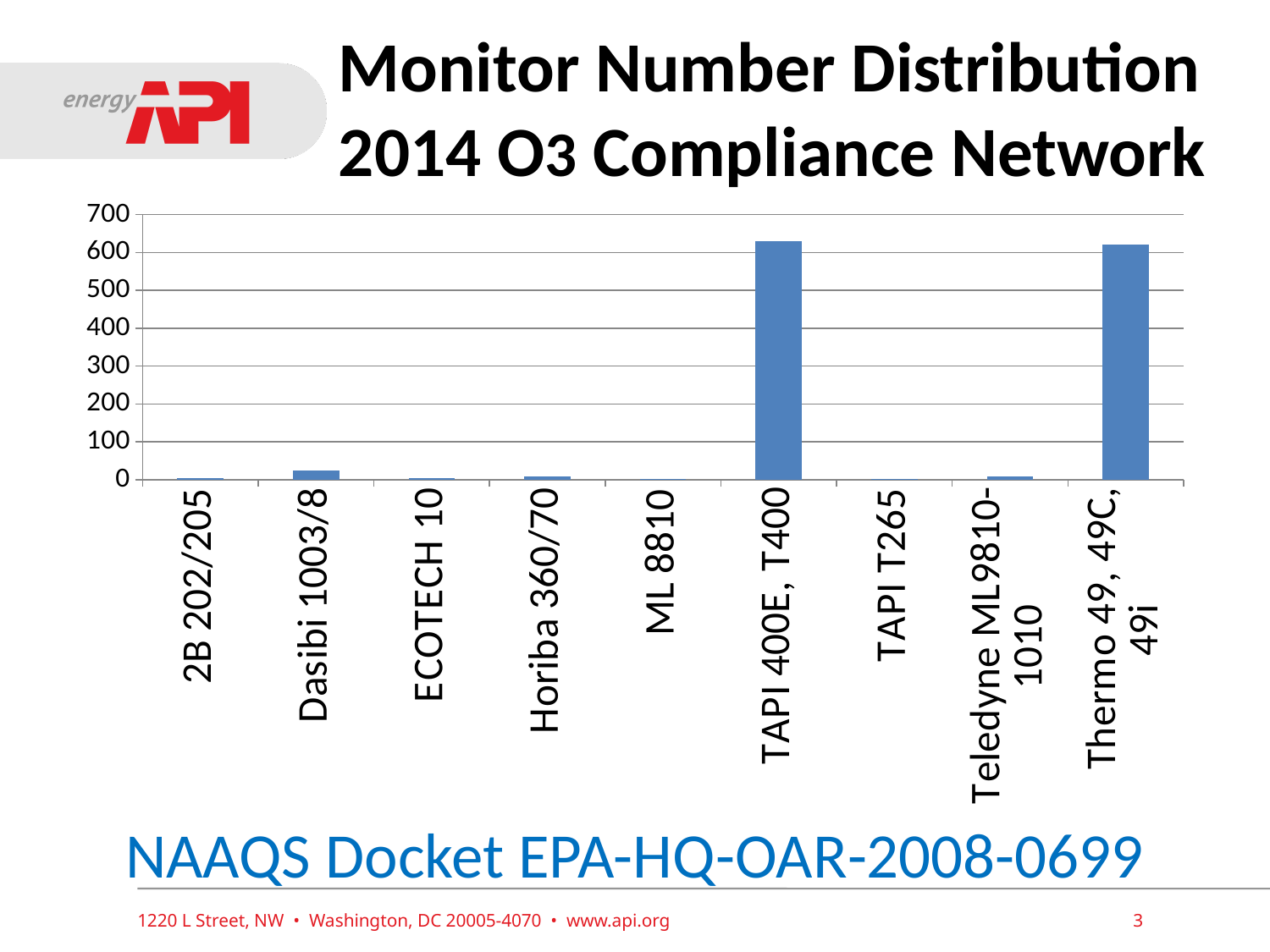
Is the value for TAPI T265 greater or less than 100? less Which has the larger value, TAPI 400E, T400 or Dasibi 1003/8? TAPI 400E, T400 Is the value for Dasibi 1003/8 greater or less than 100? less Which has the larger value, Dasibi 1003/8 or ML 8810? Dasibi 1003/8 What kind of chart is shown on the slide? bar chart What is the title of the chart on the slide? Monitor Number Distribution 2014 O3 Compliance Network Is the value for ECOTECH 10 greater or less than 100? less What is the highest value shown on the y axis of the chart? 700 Which has the larger value, Thermo 49, 49C, 49i or Horiba 360/70? Thermo 49, 49C, 49i How many monitor categories are shown on the x axis of the chart? 9